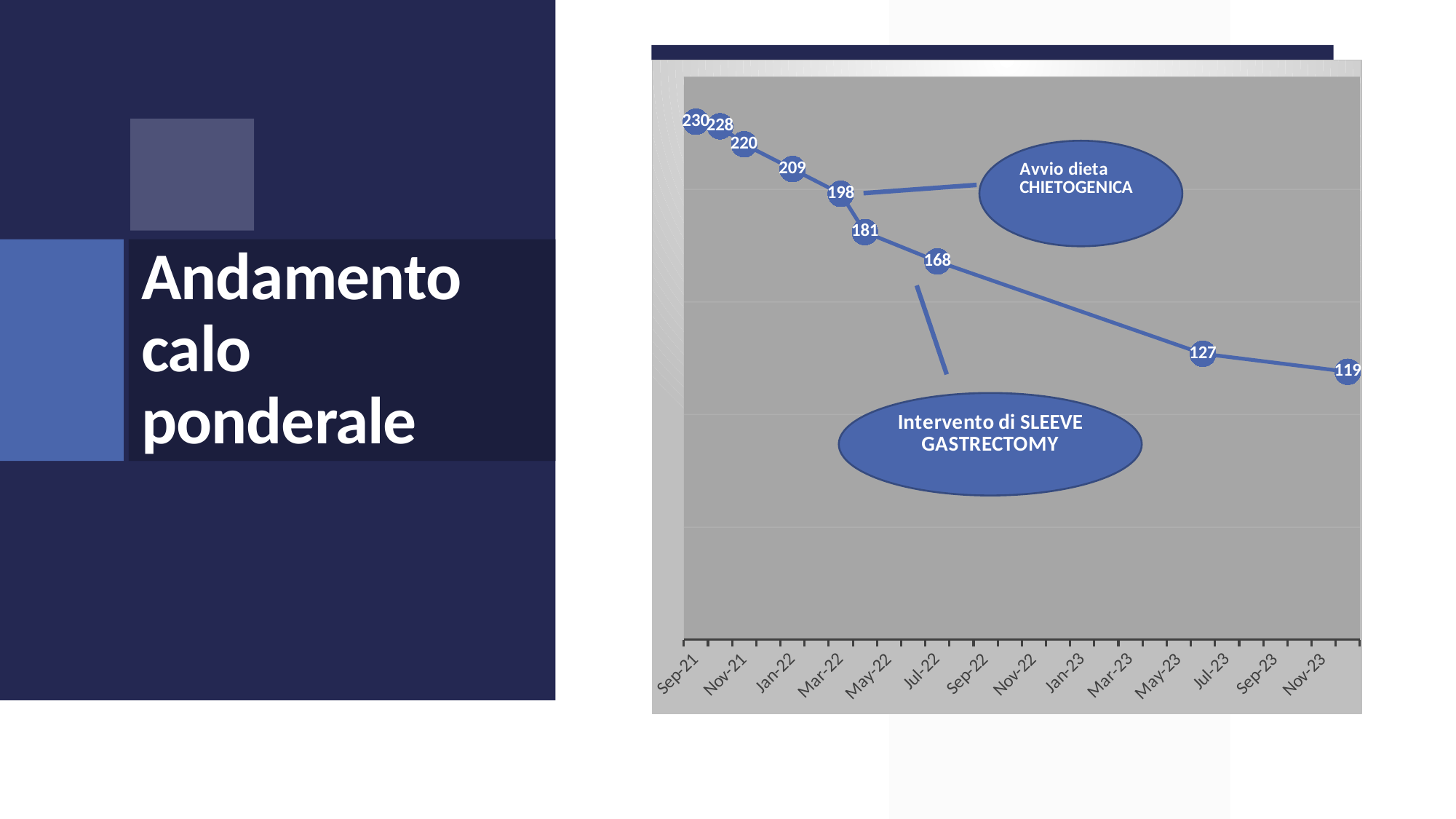
What is the difference between the data points labelled 198 and 181? 17 How many data points are labelled on the line chart? 9 Which is larger on the line chart: the point labelled 168 or the point labelled 127? 168 Do the values on the line chart rise or fall from left to right along the x axis? fall What kind of chart is shown on the slide? line chart What is the value of the last data point on the line chart? 119 What is the difference between the first value (230) and the last value (119) on the line chart? 111 What is the highest value labelled on the line chart? 230 What is the value of the first data point on the line chart? 230 What is the title of the slide containing the line chart? Andamento calo ponderale Which data point does the annotation 'Avvio dieta CHIETOGENICA' point to? 198 What is the lowest value labelled on the line chart? 119